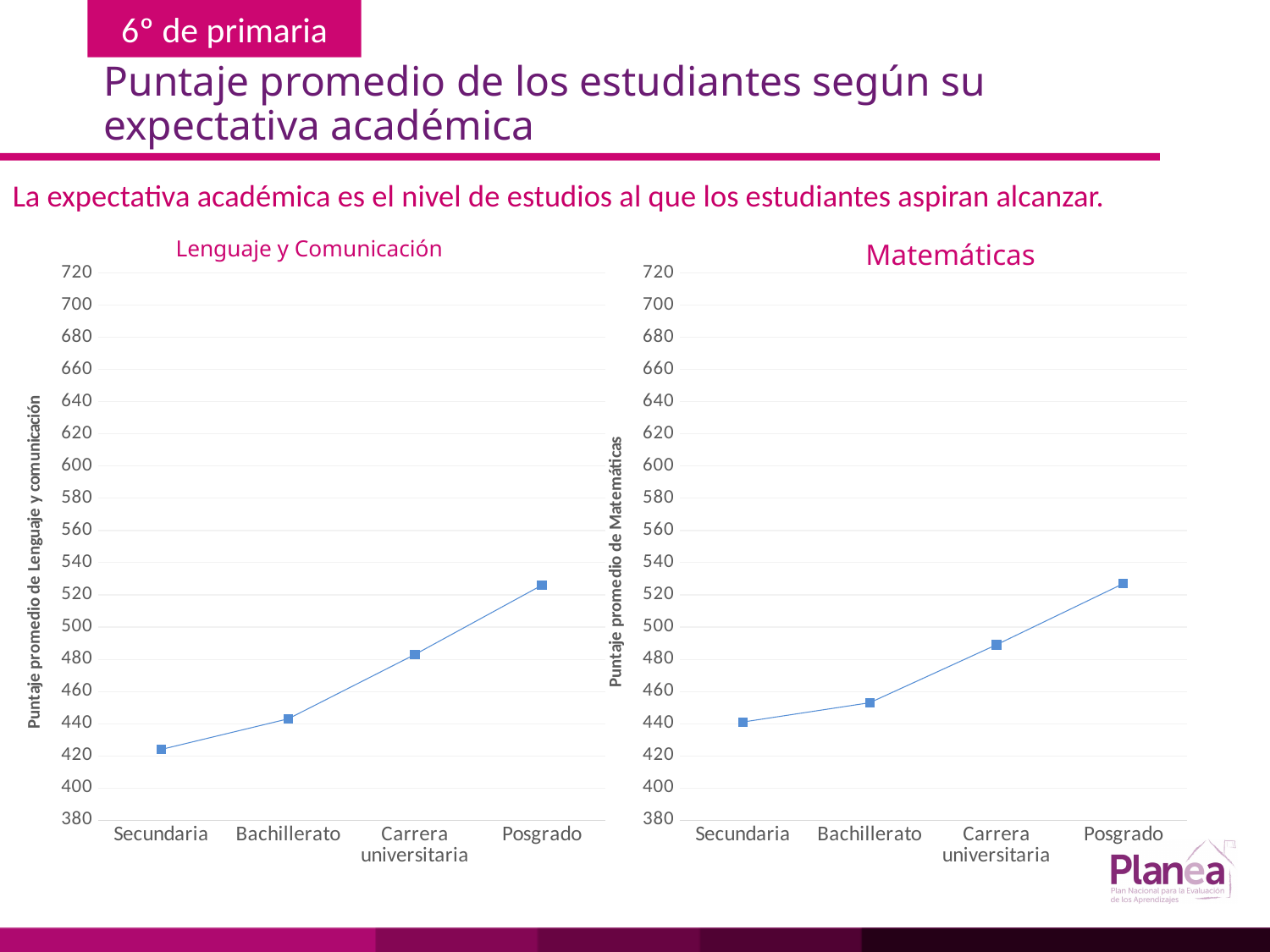
In the Matemáticas chart, which category has the lowest average score? Secundaria In the Matemáticas chart, which is larger, the value for Bachillerato or the value for Carrera universitaria? Carrera universitaria In the Lenguaje y Comunicación chart, which category has the highest average score? Posgrado In the Matemáticas chart, is the value for Carrera universitaria greater or less than 480? greater In the Matemáticas chart, which category has the highest average score? Posgrado In the Matemáticas chart, is the value for Bachillerato greater or less than 460? less In the Lenguaje y Comunicación chart, is the value for Posgrado greater or less than 500? greater What kind of chart is the Matemáticas chart? Line chart In the Lenguaje y Comunicación chart, which category has the lowest average score? Secundaria How many categories are shown on the x axis of the Lenguaje y Comunicación chart? 4 In the Lenguaje y Comunicación chart, do the values rise or fall from Secundaria to Posgrado? Rise